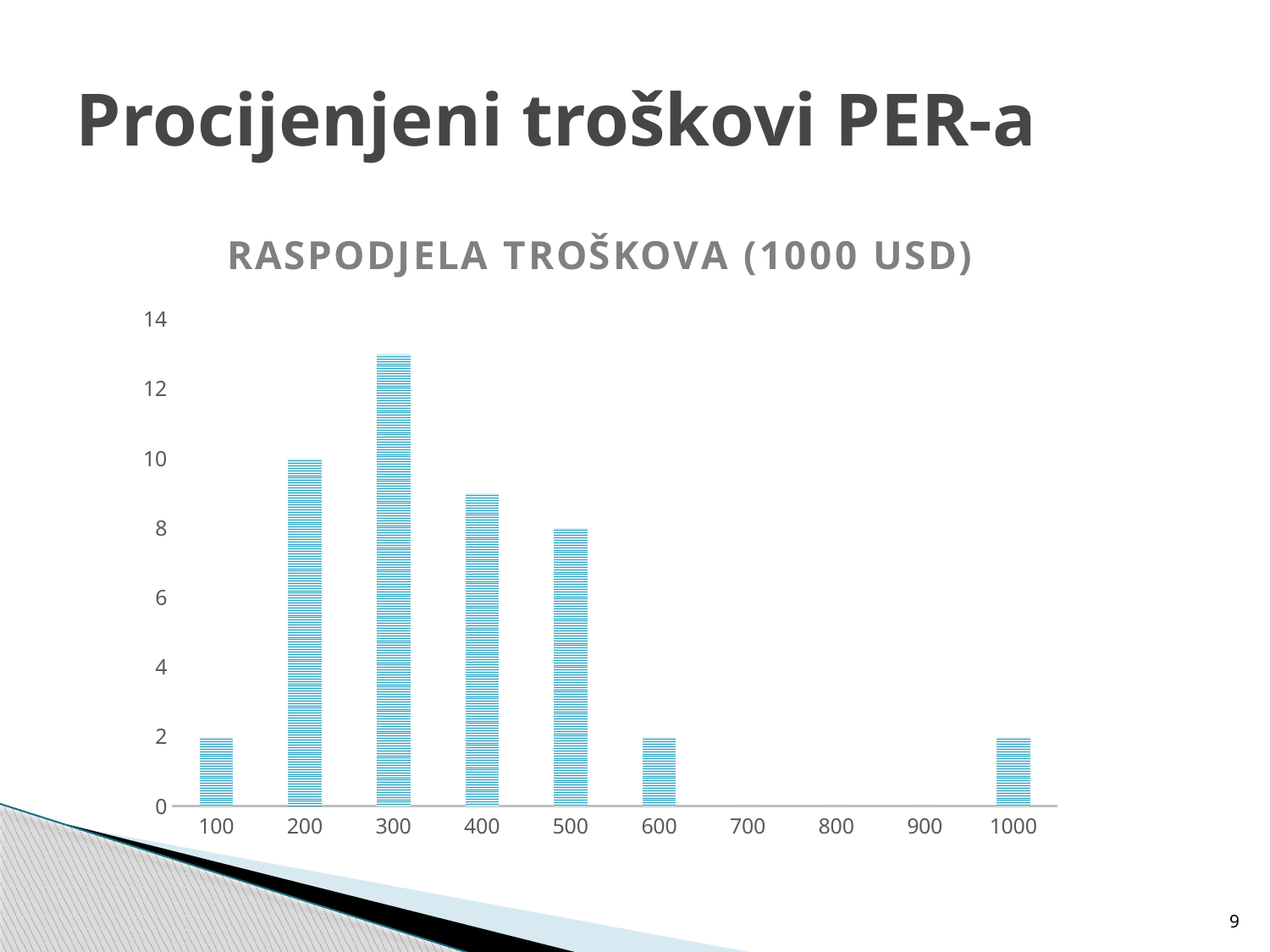
Which category has the highest bar? 300 What is the value for category 200? 10 What is the value for category 500? 8 What kind of chart is shown on the slide? bar chart What is the difference between the values for categories 200 and 500? 2 Do the values rise or fall from category 300 to category 600? fall Is the value for category 300 greater or less than 12? greater What is the title of the chart? RASPODJELA TROŠKOVA (1000 USD) What is the value for category 100? 2 How many categories are shown on the x axis? 10 Is the value for category 400 greater or less than 10? less What is the value for category 1000? 2